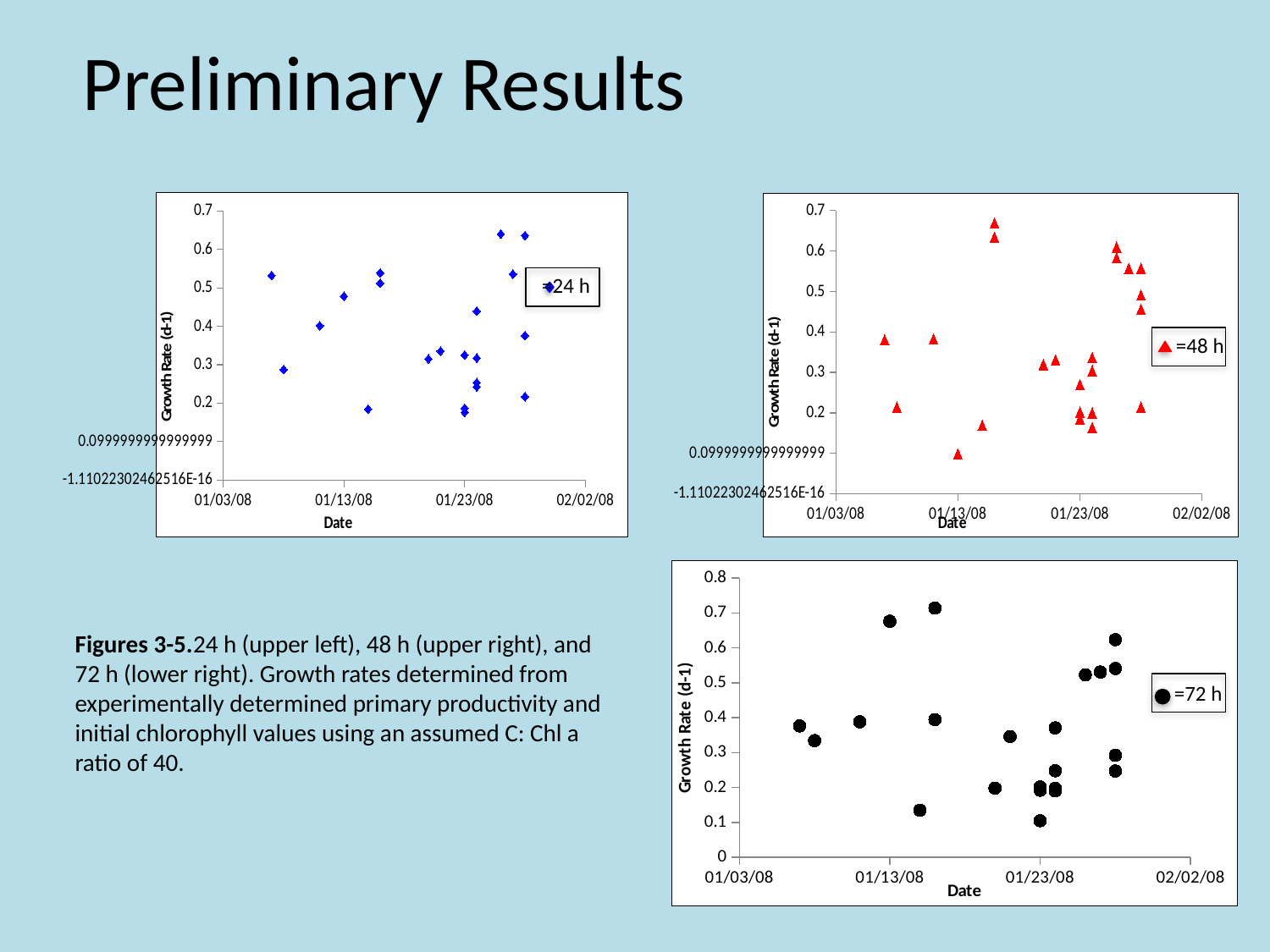
What is the legend entry shown in the upper-right chart? =48 h What is the highest tick value shown on the y-axis of the lower-right chart (72 h)? 0.8 In the upper-left chart (24 h), is the highest plotted growth rate greater or less than 0.6? greater In the upper-right chart (48 h), is the lowest plotted growth rate greater or less than 0.2? less In the upper-left chart (24 h), is the lowest plotted growth rate greater or less than 0.2? less What is the y-axis title of the lower-right chart (72 h)? Growth Rate (d-1) What kind of chart is the upper-left chart labelled 24 h? Scatter chart What is the last date tick shown on the x-axis of the upper-left chart (24 h)? 02/02/08 How many series does the legend of the lower-right chart (72 h) list? 1